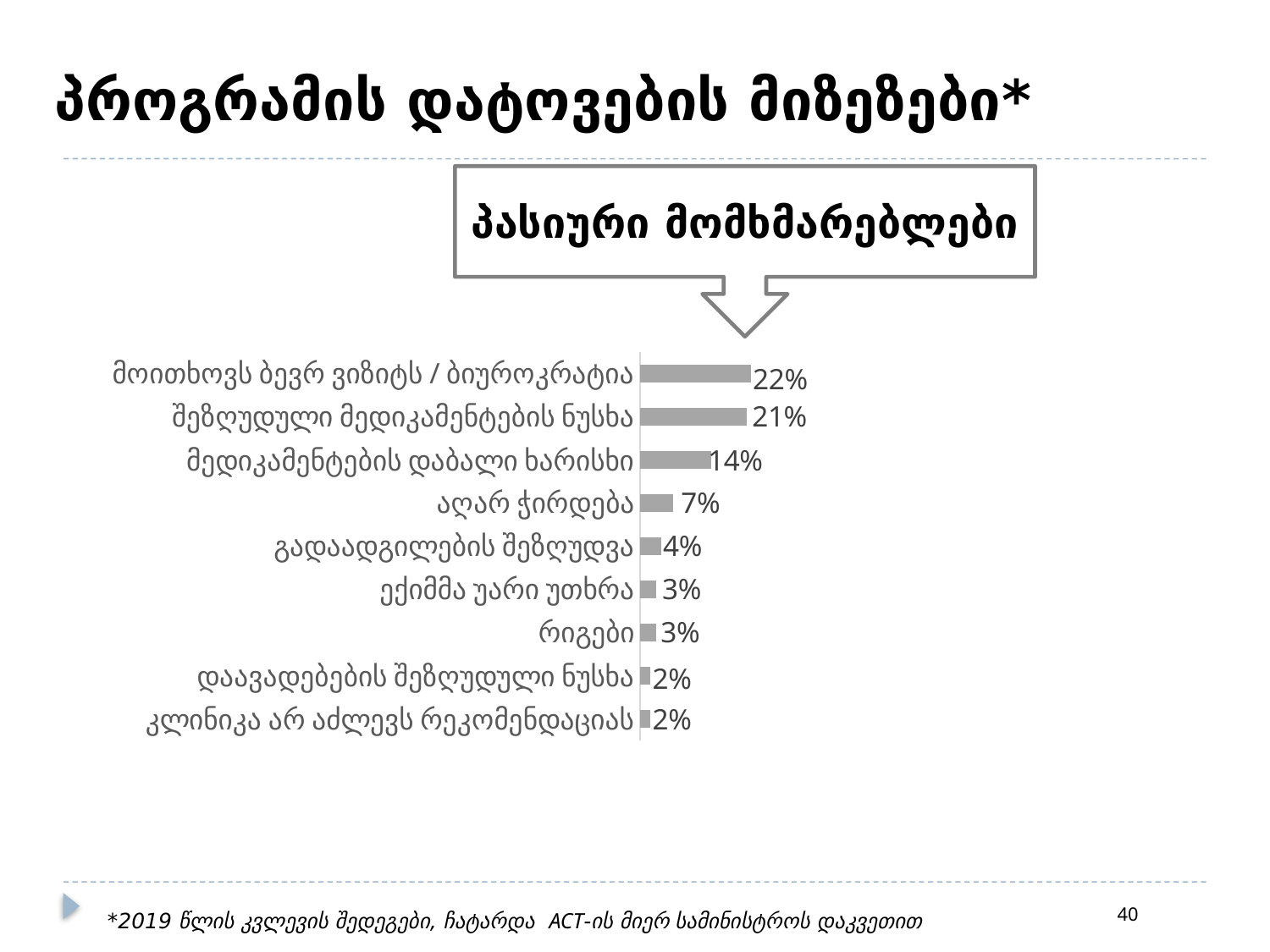
What is the title of the slide? პროგრამის დატოვების მიზეზები* What is the difference between the values for "მოითხოვს ბევრ ვიზიტს / ბიუროკრატია" and "აღარ ჭირდება"? 15% What value is shown for "მოითხოვს ბევრ ვიზიტს / ბიუროკრატია"? 22% What is the difference between the values for "შეზღუდული მედიკამენტების ნუსხა" and "მედიკამენტების დაბალი ხარისხი"? 7% What value is shown for "აღარ ჭირდება"? 7% What kind of chart is shown on the slide? Bar chart What value is shown for "მედიკამენტების დაბალი ხარისხი"? 14% What text appears in the callout box above the chart? პასიური მომხმარებლები Which is larger, the value for "აღარ ჭირდება" or the value for "გადაადგილების შეზღუდვა"? აღარ ჭირდება How many categories are shown in the chart? 9 What value is shown for "გადაადგილების შეზღუდვა"? 4% Which category has the highest value in the chart? მოითხოვს ბევრ ვიზიტს / ბიუროკრატია